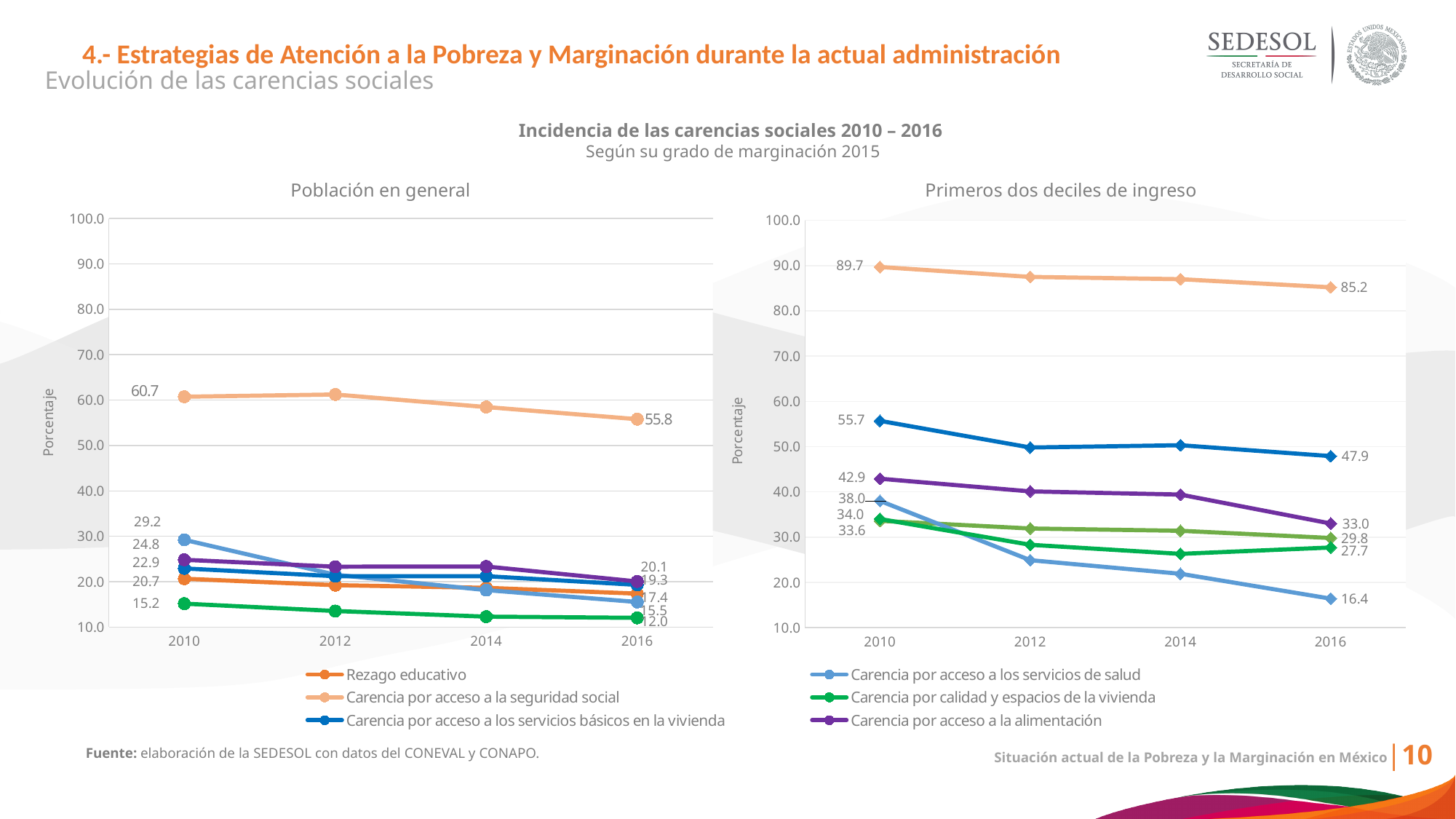
In the 'Población en general' chart, which series has the lowest value in 2016? Carencia por calidad y espacios de la vivienda In the 'Primeros dos deciles de ingreso' chart, what is the value for 'Carencia por acceso a los servicios básicos en la vivienda' in 2010? 55.7 What kind of chart is the 'Población en general' chart? line chart In the 'Población en general' chart, by how much did 'Carencia por acceso a la seguridad social' fall from 2010 to 2016? 4.9 In the 'Primeros dos deciles de ingreso' chart, is the 2012 value for 'Carencia por acceso a los servicios de salud' greater or less than 30.0? less In the 'Población en general' chart, what is the value for 'Carencia por acceso a la seguridad social' in 2010? 60.7 In the 'Primeros dos deciles de ingreso' chart, does 'Carencia por acceso a los servicios de salud' rise or fall from 2010 to 2016? fall In the 'Primeros dos deciles de ingreso' chart, what is the difference between the 2010 and 2016 values for 'Carencia por acceso a la alimentación'? 9.9 How many years are plotted on the x axis of the 'Primeros dos deciles de ingreso' chart? 4 In the 'Primeros dos deciles de ingreso' chart, what is the value for 'Carencia por acceso a la seguridad social' in 2016? 85.2 How many series does the legend list for the charts? 6 In the 'Población en general' chart, what is the value for 'Carencia por acceso a los servicios de salud' in 2016? 15.5